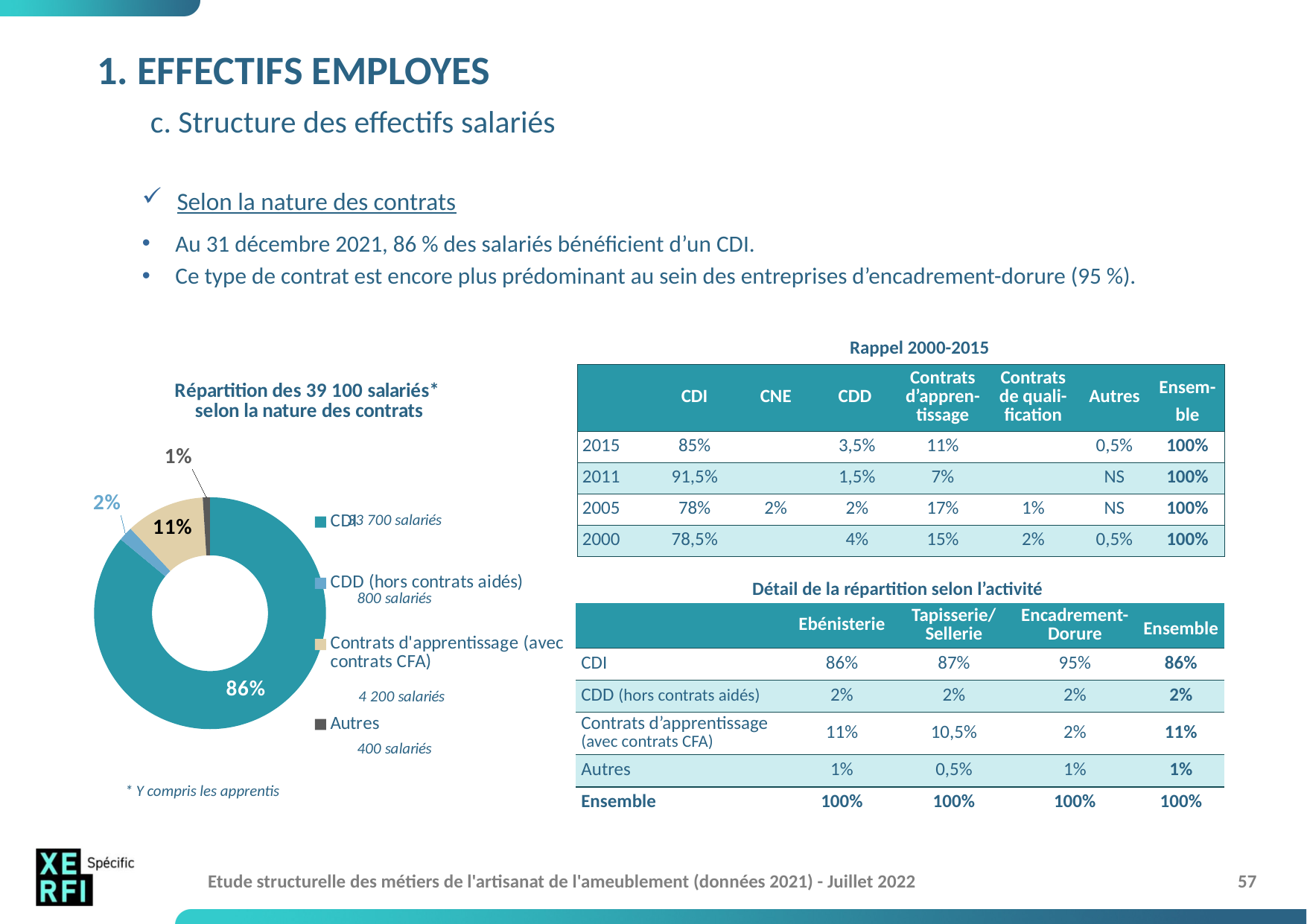
Which category has the largest slice in the pie chart? CDI In the pie chart, what share of employees are on 'Contrats d'apprentissage (avec contrats CFA)'? 11% In the pie chart, what share of employees fall under 'Autres'? 1% According to the annotation next to the pie chart, how many employees are on 'Contrats d'apprentissage (avec contrats CFA)'? 4 200 salariés What total number of employees does the pie chart's title say it covers? 39 100 salariés What kind of chart is shown under the title 'Répartition des 39 100 salariés* selon la nature des contrats'? Pie chart (doughnut) In the pie chart, what share of employees have a CDI? 86% In the pie chart, which slice is larger: 'CDD (hors contrats aidés)' or 'Contrats d'apprentissage (avec contrats CFA)'? Contrats d'apprentissage (avec contrats CFA) In the pie chart, what is the difference in percentage points between the CDI slice and the 'Contrats d'apprentissage' slice? 75 percentage points In the pie chart, what share of employees are on 'CDD (hors contrats aidés)'? 2% How many categories does the pie chart's legend list? 4 Which category has the smallest slice in the pie chart? Autres